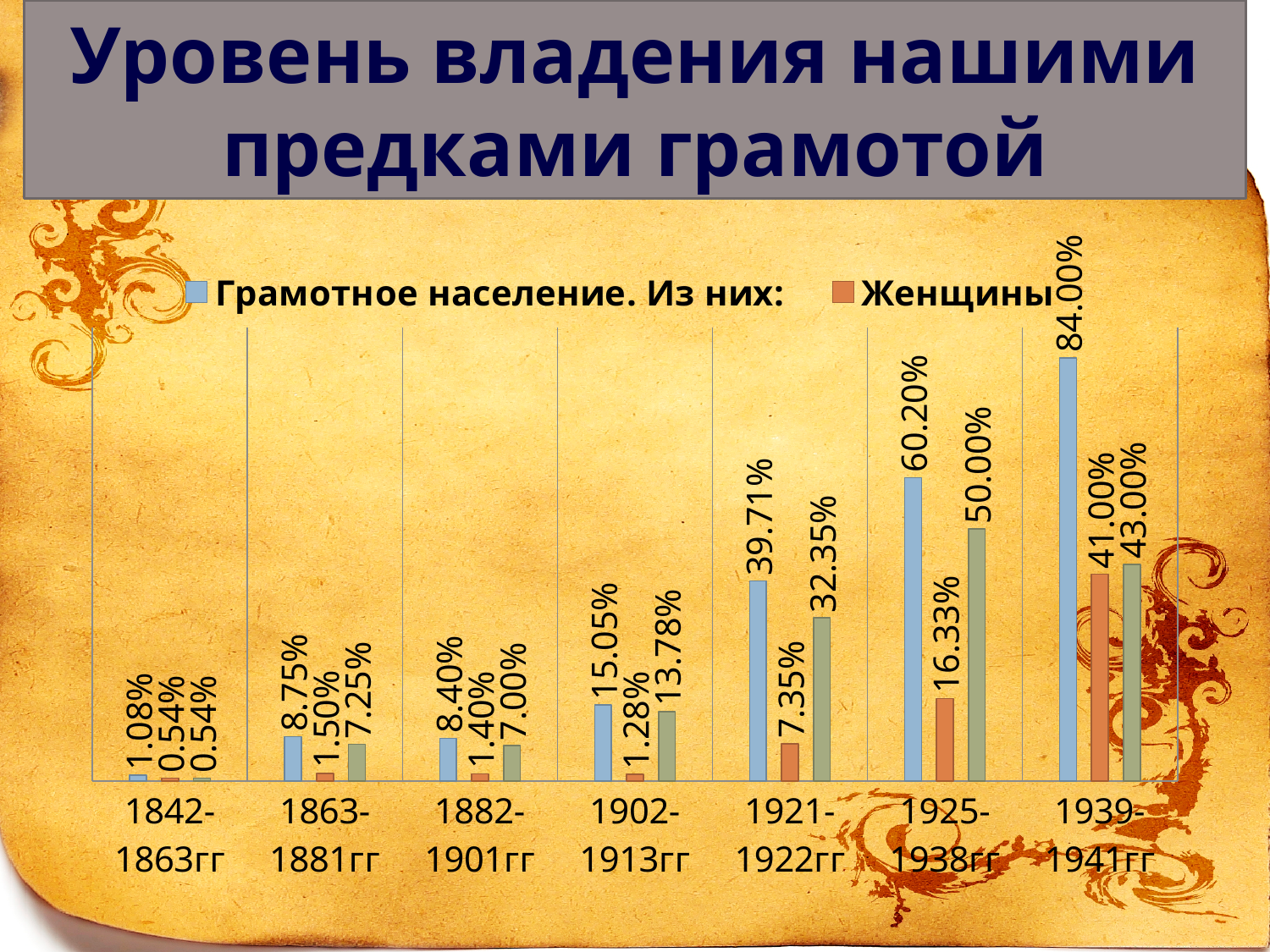
What is the value for Женщины in the 1925-1938гг period? 16.33% What is the difference between Грамотное население and Женщины in the 1939-1941гг period? 43.00% What is the title of the slide? Уровень владения нашими предками грамотой Do the Грамотное население values generally rise or fall from 1842-1863гг to 1939-1941гг? Rise What is the value for Женщины in the 1902-1913гг period? 1.28% How many time periods are shown on the x axis? 7 What kind of chart is shown on the slide? Bar chart What is the value for Грамотное население in the 1939-1941гг period? 84.00% What is the value for Грамотное население in the 1921-1922гг period? 39.71% Which period has the lowest value for Женщины? 1842-1863гг Which is larger: the Грамотное население value for 1863-1881гг or for 1882-1901гг? 1863-1881гг Which period has the highest value for Грамотное население? 1939-1941гг